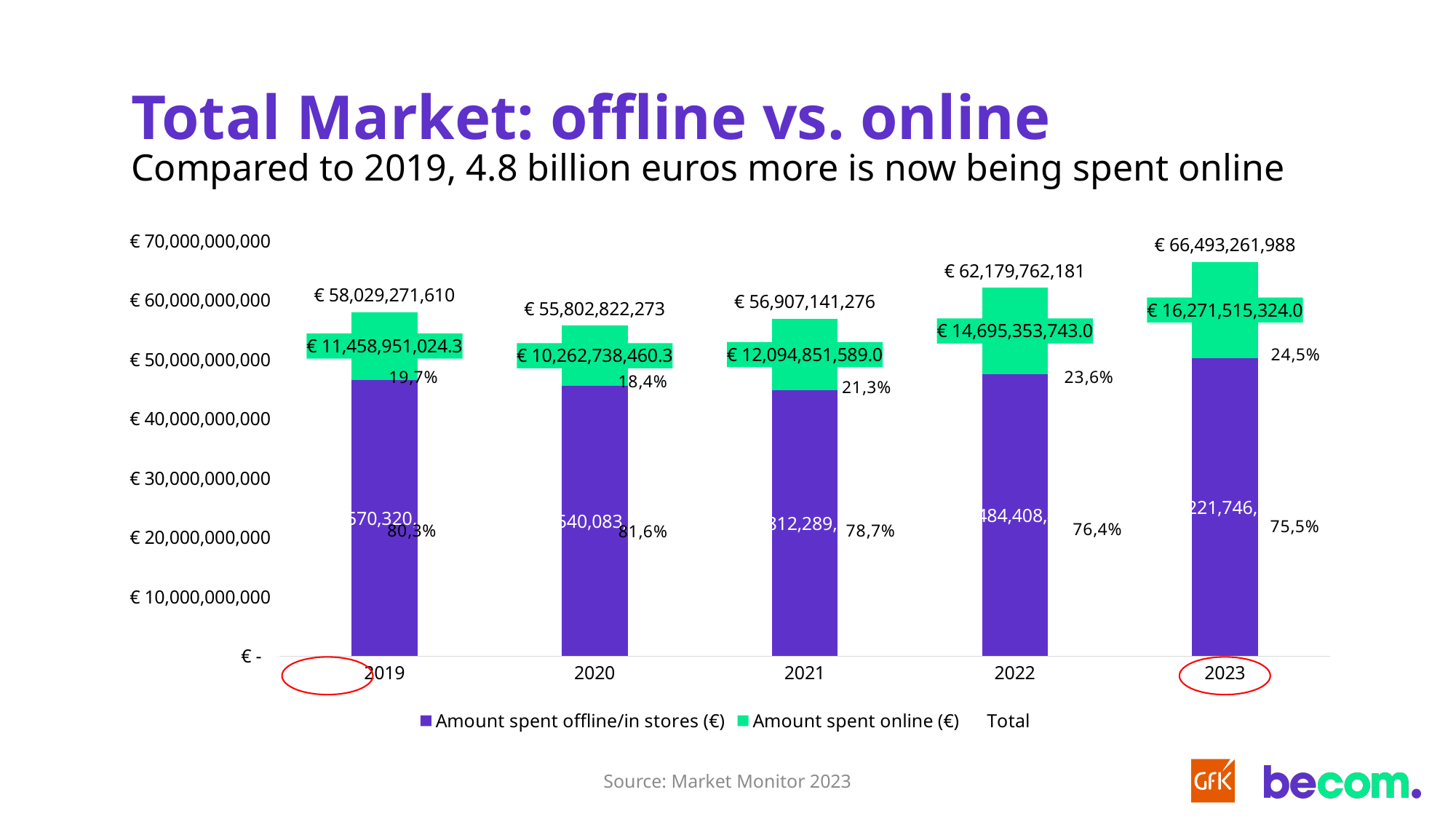
Which year has the highest total market value? 2023 Which year had a larger amount spent online, 2020 or 2021? 2021 How much more was spent online in 2023 than in 2019? € 4,812,564,299.7 What is the amount spent online in 2023? € 16,271,515,324.0 How many entries does the legend list? 3 Which year has the lowest total market value? 2020 Is the amount spent offline/in stores in 2023 greater or less than € 40,000,000,000? greater Does the amount spent online rise or fall from 2020 to 2023? Rise What percentage of the market was spent online in 2021? 21,3% What is the total market value shown for 2022? € 62,179,762,181 How many years are shown on the x axis? 5 What kind of chart is shown on the slide? Stacked bar chart